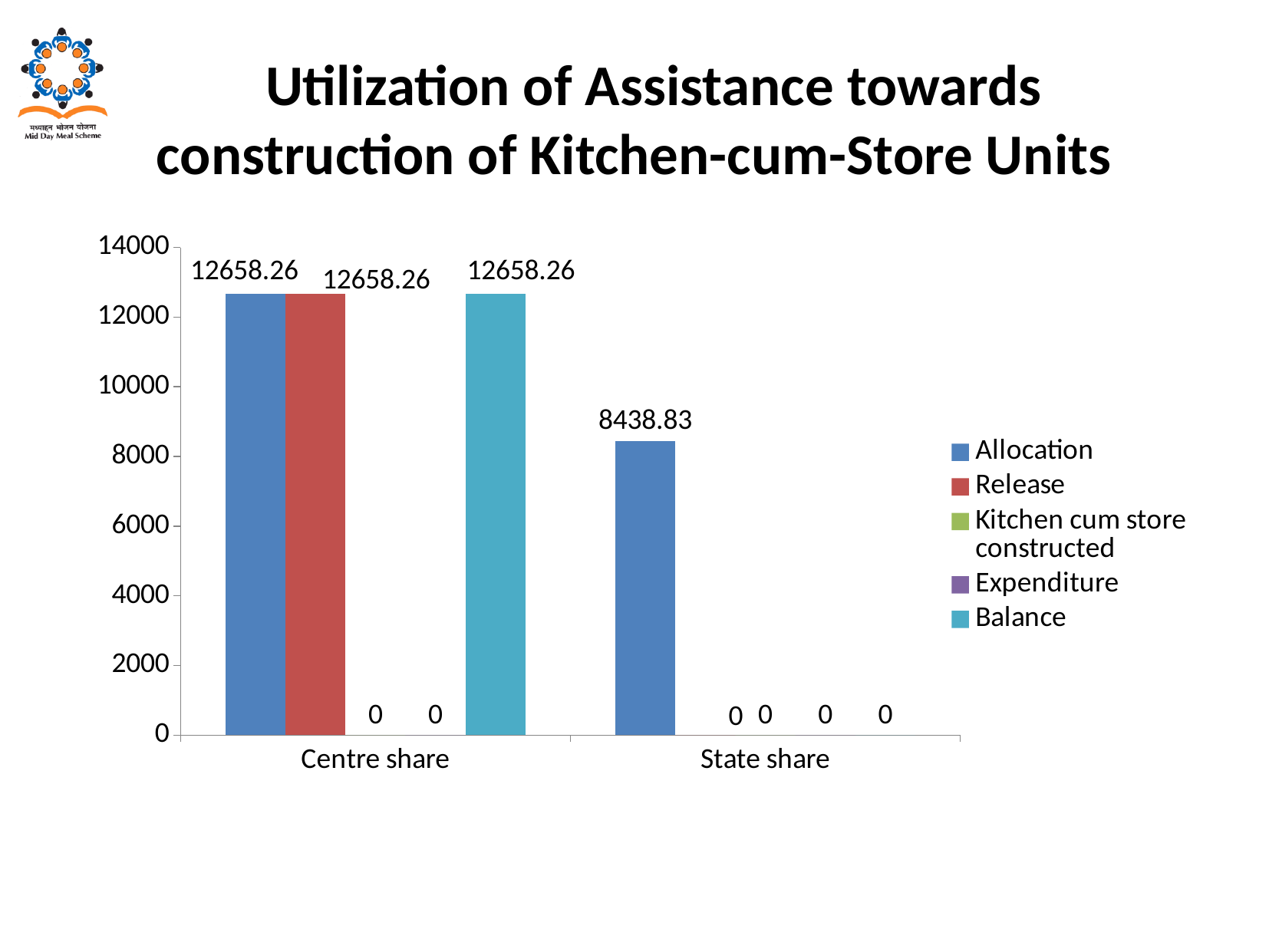
What is the title of the chart on the slide? Utilization of Assistance towards construction of Kitchen-cum-Store Units What is the Balance value for Centre share? 12658.26 What is the Allocation value for Centre share? 12658.26 What is the Release value for State share? 0 Is the Allocation value for State share greater or less than 10000? less Which category has the higher Allocation, Centre share or State share? Centre share How many series does the legend list? 5 What is the difference between the Allocation for Centre share and the Allocation for State share? 4219.43 What kind of chart is shown on the slide? bar chart What is the Expenditure value for Centre share? 0 How many categories are shown on the x axis? 2 What is the Allocation value for State share? 8438.83